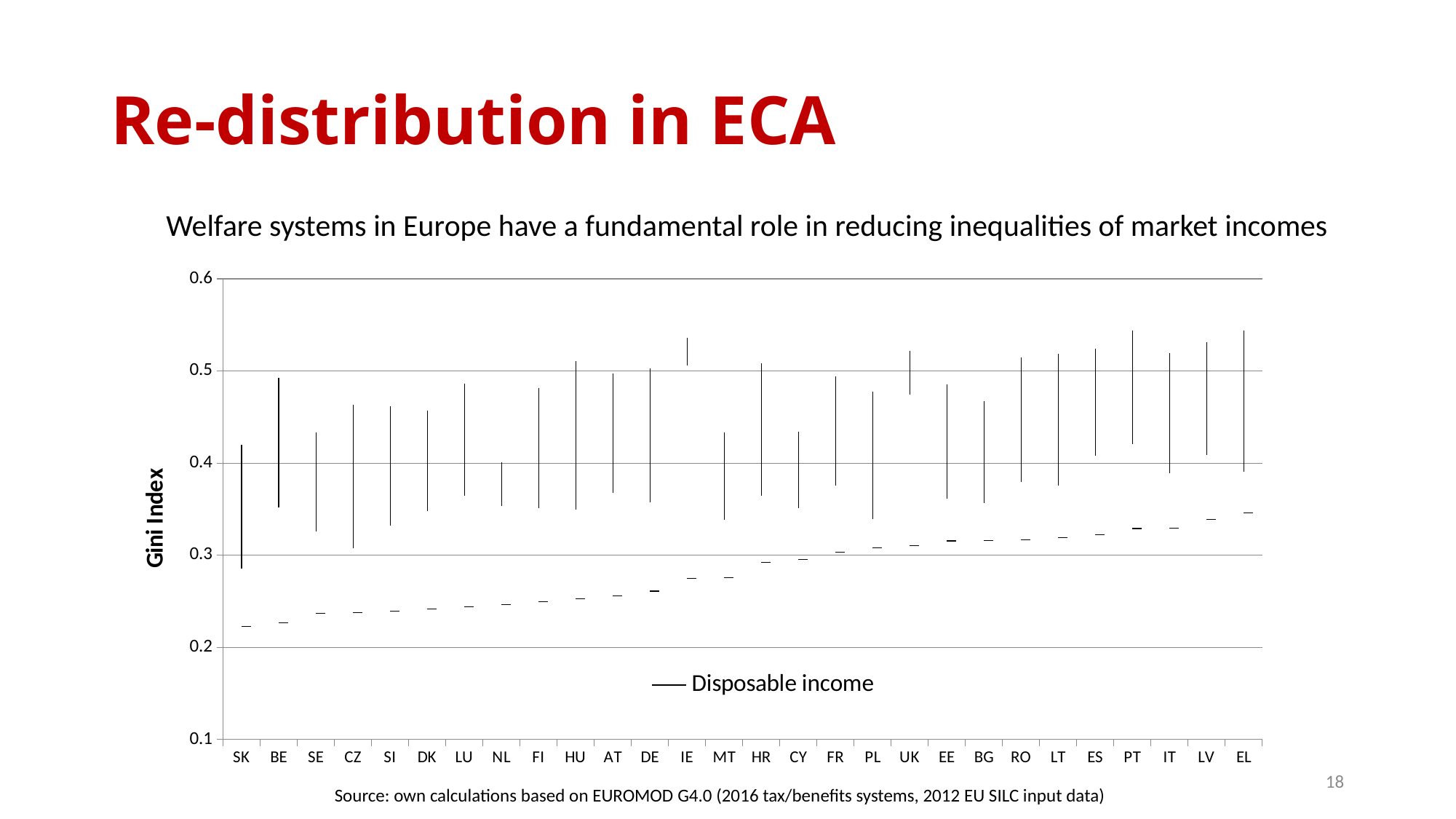
Is the disposable income Gini value for DE greater or less than 0.3? less What is the label on the chart's vertical axis? Gini Index Do the disposable income Gini values rise or fall moving from SK on the left to EL on the right? rise What series name appears in the chart's legend? Disposable income How many countries are shown along the x axis of the chart? 28 Is the disposable income Gini value for EL greater or less than 0.3? greater Is the disposable income Gini value for SK greater or less than 0.3? less How many series does the chart's legend list? 1